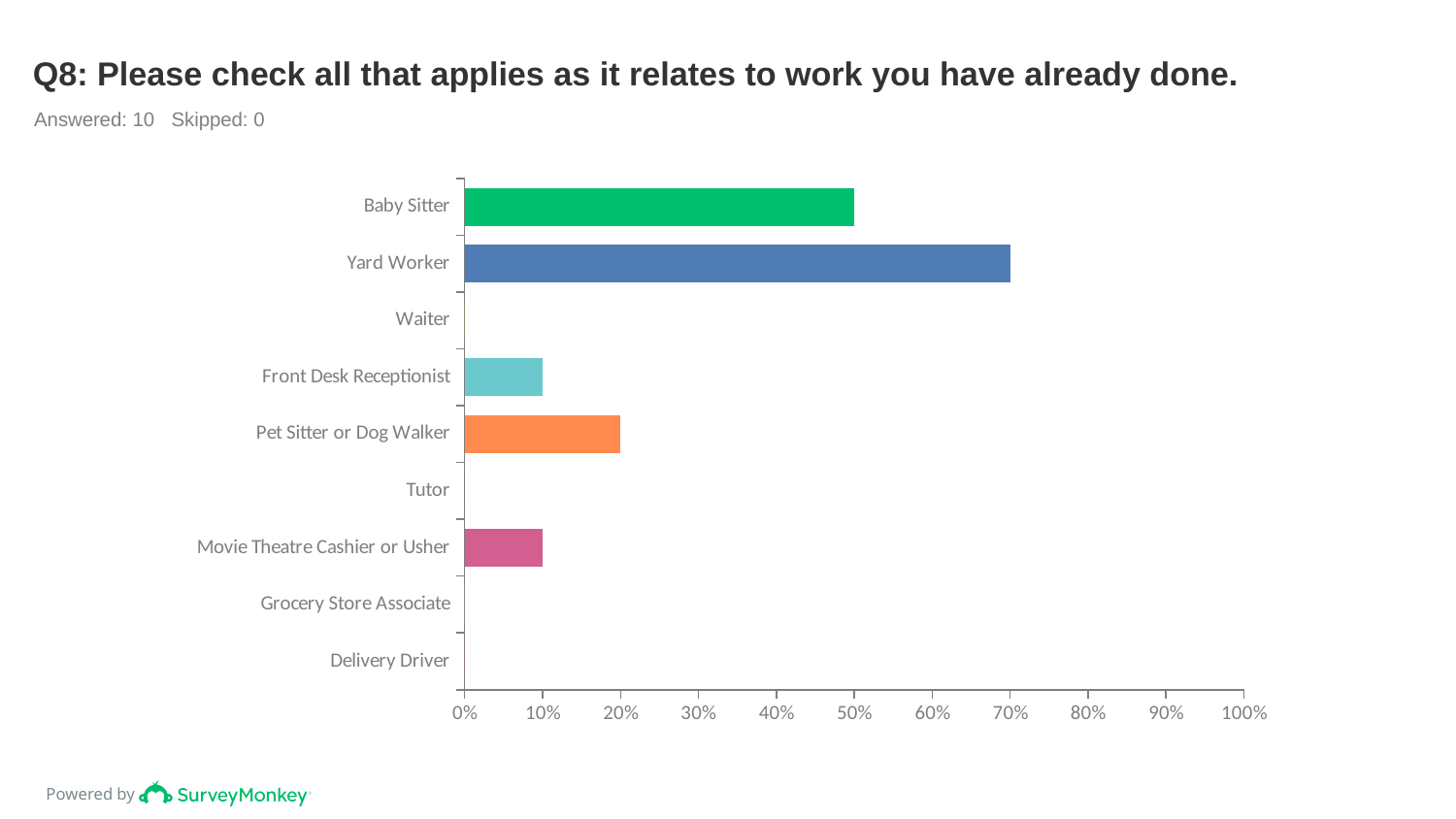
Which category has the highest value? Yard Worker How many categories are listed on the chart? 9 What is the title of the chart? Q8: Please check all that applies as it relates to work you have already done. Is the value for Baby Sitter greater or less than 40%? greater Which is larger, the value for Pet Sitter or Dog Walker or the value for Movie Theatre Cashier or Usher? Pet Sitter or Dog Walker What is the value for Yard Worker? 70% What is the difference between the values for Yard Worker and Baby Sitter? 20% What is the difference between the values for Pet Sitter or Dog Walker and Front Desk Receptionist? 10% What is the value for Pet Sitter or Dog Walker? 20% What kind of chart is shown on the slide? bar chart What is the value for Front Desk Receptionist? 10% What is the value for Baby Sitter? 50%